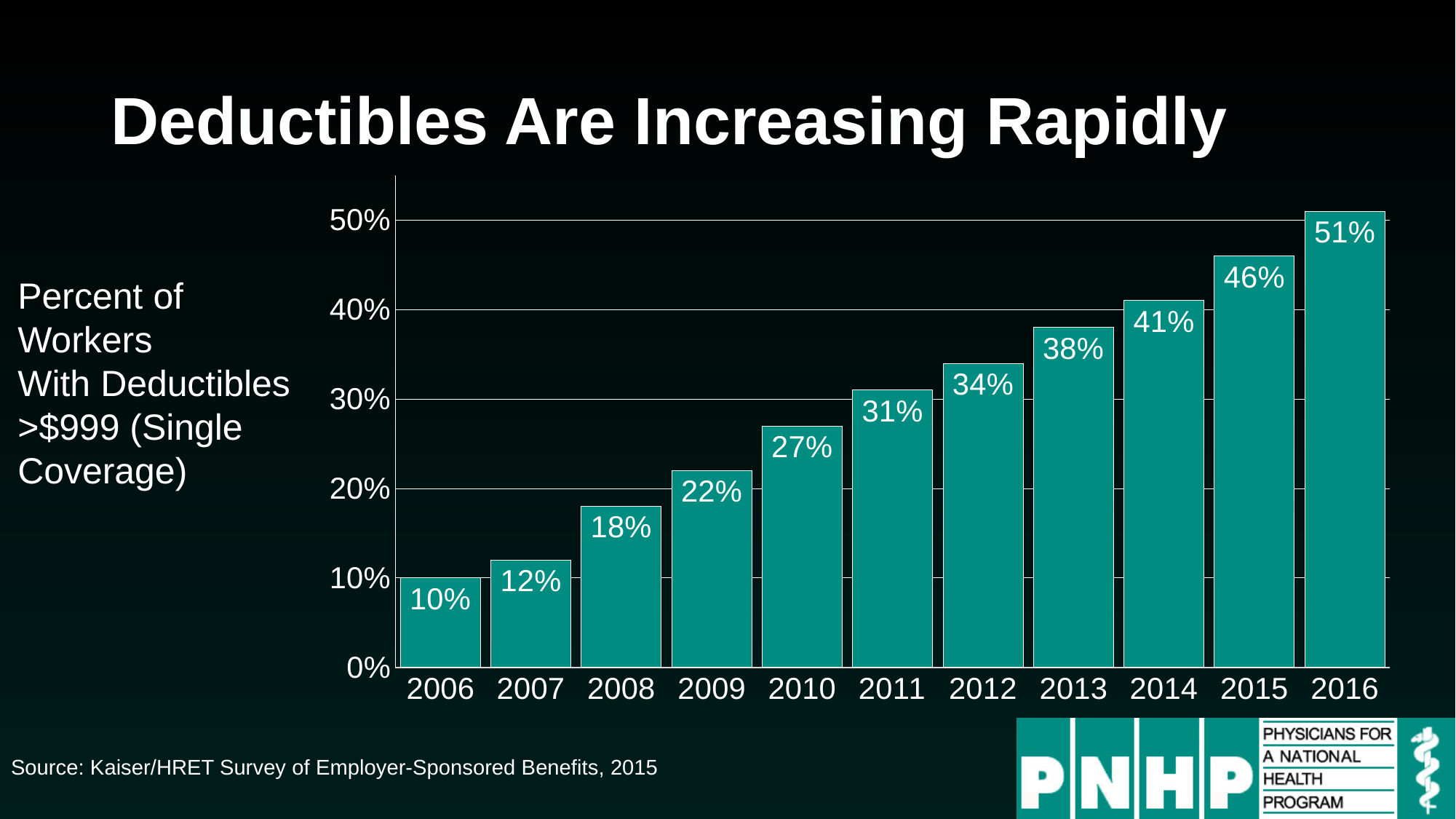
Which is larger, the value for 2009 or the value for 2011? 2011 What is the value for 2010? 27% Which year has the lowest value? 2006 What is the value for 2006? 10% Is the value for 2015 greater or less than 40%? greater Do the values rise or fall from 2006 to 2016? rise Which year has the highest value? 2016 What is the difference between the values for 2016 and 2006? 41% What is the value for 2014? 41% What is the difference between the values for 2013 and 2012? 4% What kind of chart is shown on the slide? bar chart How many years are shown on the x axis? 11